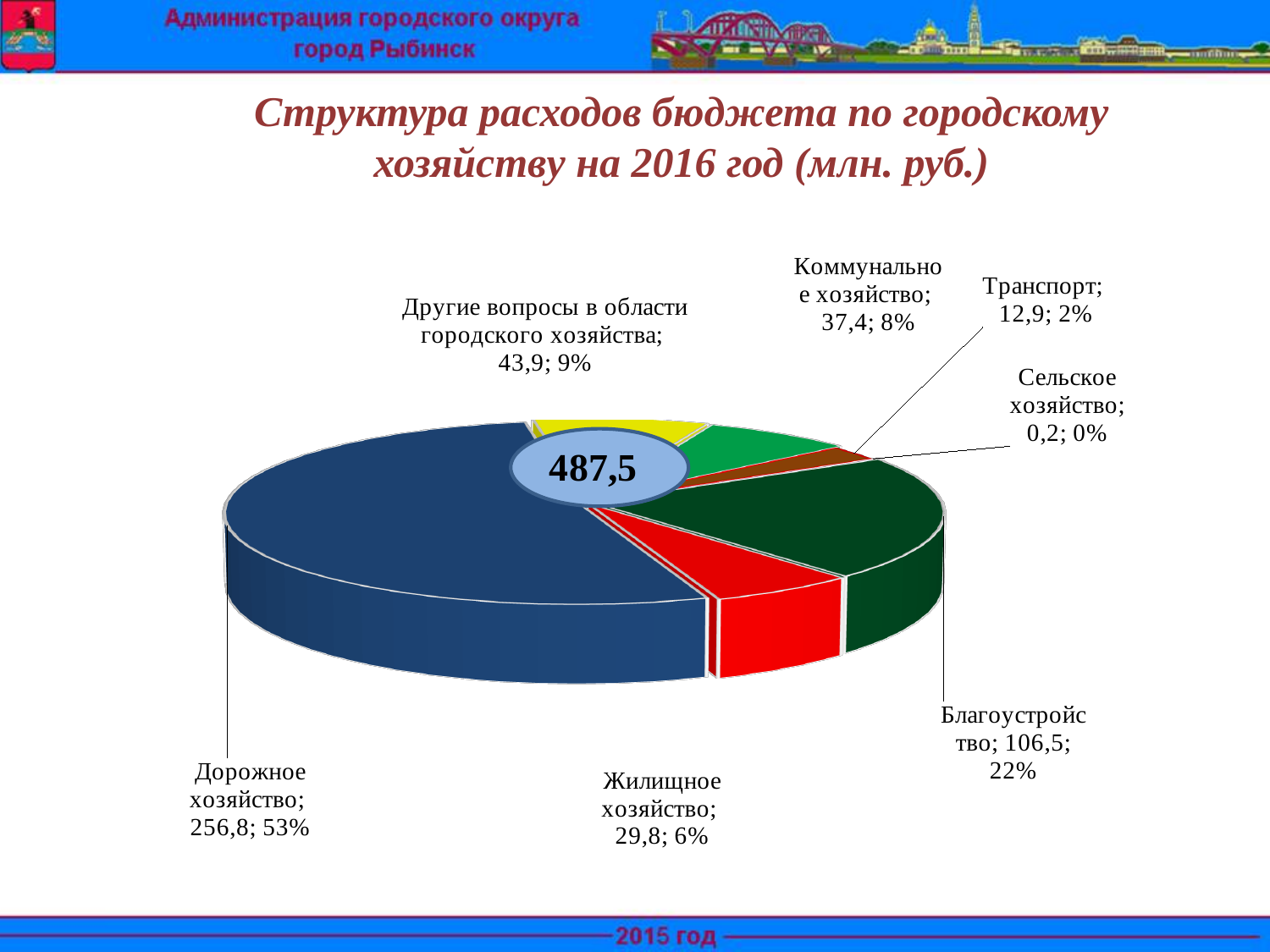
Which category has the smallest value? Сельское хозяйство What is the value for Коммунальное хозяйство? 37,4 What share of the pie does Жилищное хозяйство represent? 6% Which is larger, the value for Транспорт or the value for Жилищное хозяйство? Жилищное хозяйство What kind of chart is shown on the slide? pie chart Which category has the largest value? Дорожное хозяйство What is the title of the chart? Структура расходов бюджета по городскому хозяйству на 2016 год (млн. руб.) What is the value for Дорожное хозяйство? 256,8 How many categories are shown in the pie chart? 7 What total value is shown in the centre of the pie chart? 487,5 What share of the pie does Благоустройство represent? 22% What is the difference between the values for Дорожное хозяйство and Благоустройство? 150,3